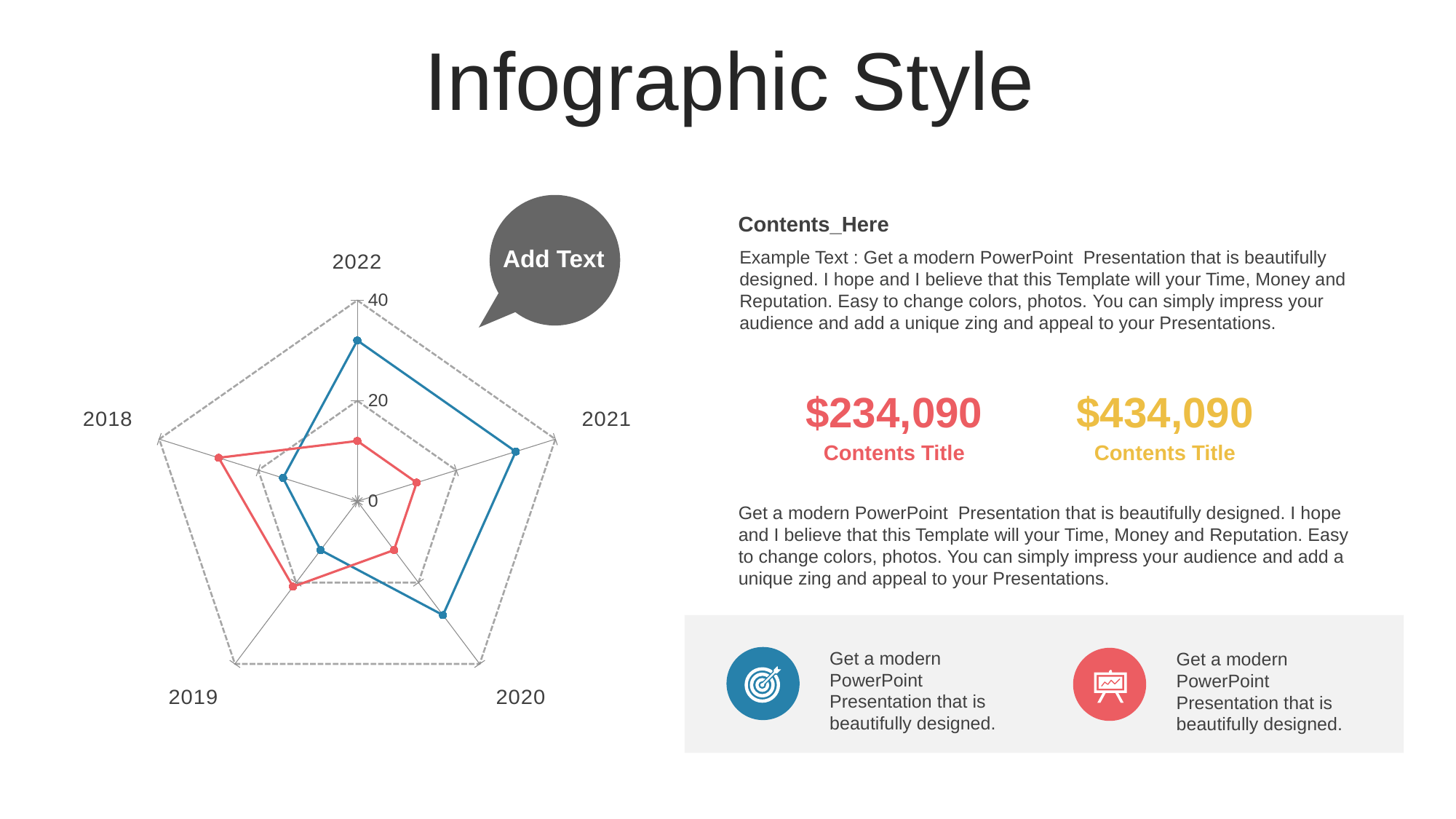
How many categories (years) does the radar chart have? 5 Is the red series value for 2022 greater or less than 20? less Is the blue series value for 2021 greater or less than 40? less Is the blue series value for 2019 greater or less than 20? less What is the highest value shown on the radar chart's axis scale? 40 What kind of chart is shown on the slide? radar chart How many data series are plotted on the radar chart? 2 For which year is the red series value highest? 2018 For 2022, which series has the larger value, the blue or the red? blue For 2018, which series has the larger value, the blue or the red? red